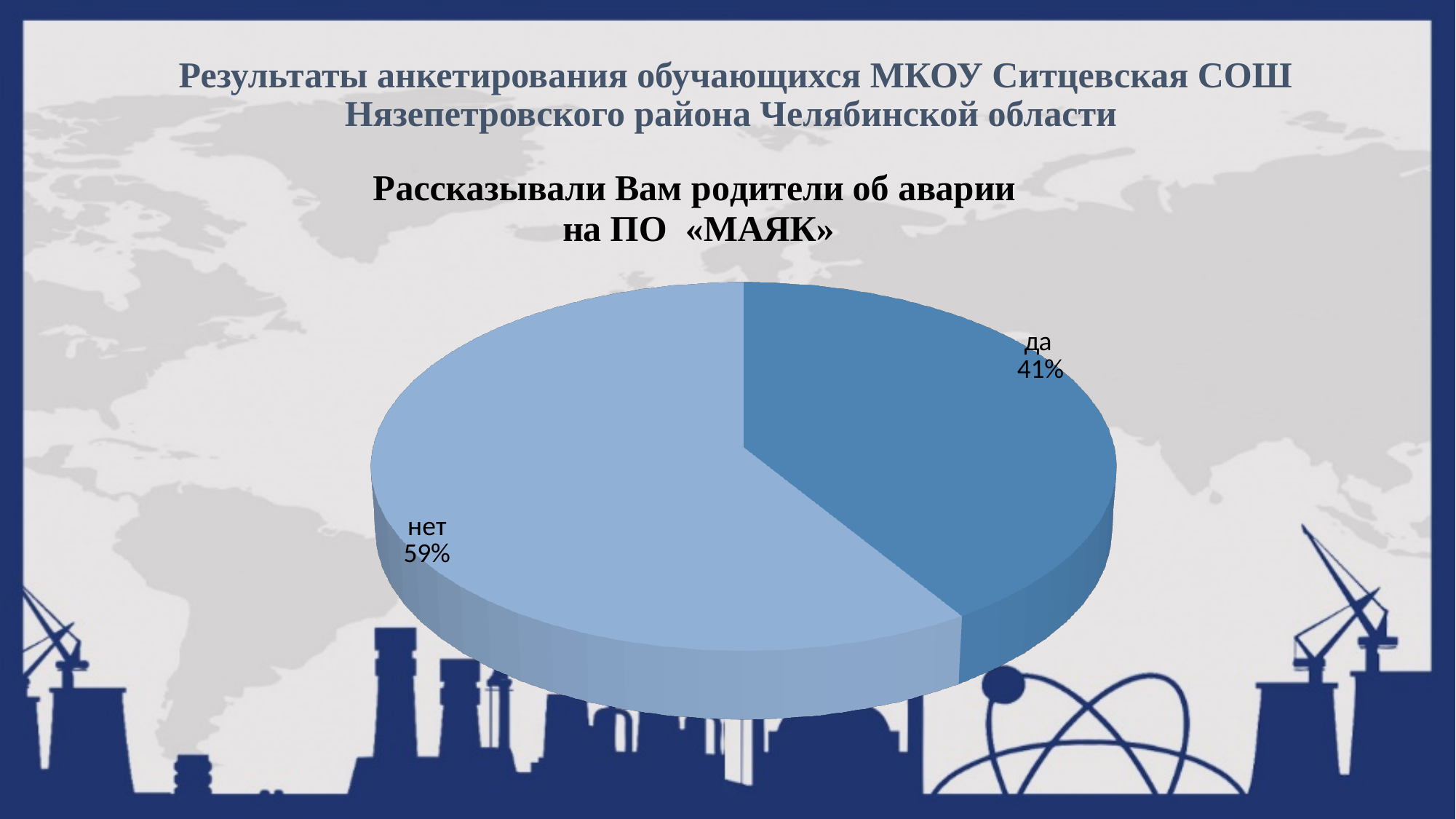
Which answer has the largest share of the pie? нет Which slice is larger, "да" or "нет"? нет What percentage of respondents answered "нет"? 59% What question does the chart title ask? Рассказывали Вам родители об аварии на ПО «МАЯК» How many slices does the pie chart have? 2 Which answer has the smallest share of the pie? да What percentage of respondents answered "да"? 41% What kind of chart is shown on the slide? pie chart What is the difference in percentage points between the "нет" and "да" slices? 18 Which slice is drawn in the darker blue colour? да What is the share of the pie taken by the "нет" slice? 59%